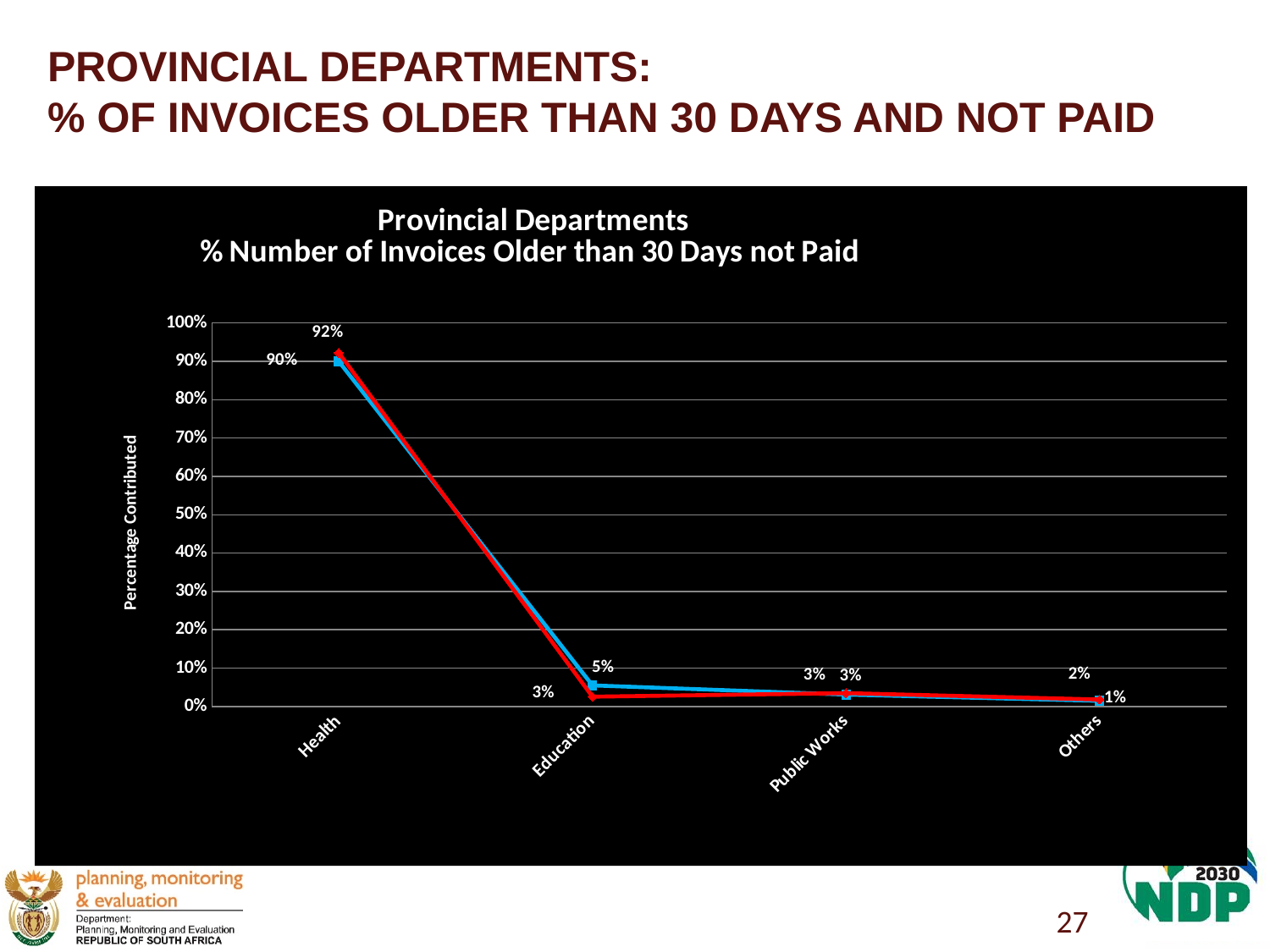
What kind of chart is shown on the slide? line chart What are the two values labelled for Health? 90% and 92% Do the values rise or fall moving from Health to Others along the x axis? fall How many categories are shown on the x axis of the chart? 4 What are the two values labelled for Education? 5% and 3% What is the difference between the two values labelled for Health? 2% Are the values for Health greater or less than 80%? greater What are the two values labelled for Public Works? 3% and 3% What are the two values labelled for Others? 2% and 1% Which category has the highest values in the chart? Health Which category has the lowest values in the chart? Others What is the title of the y axis? Percentage Contributed